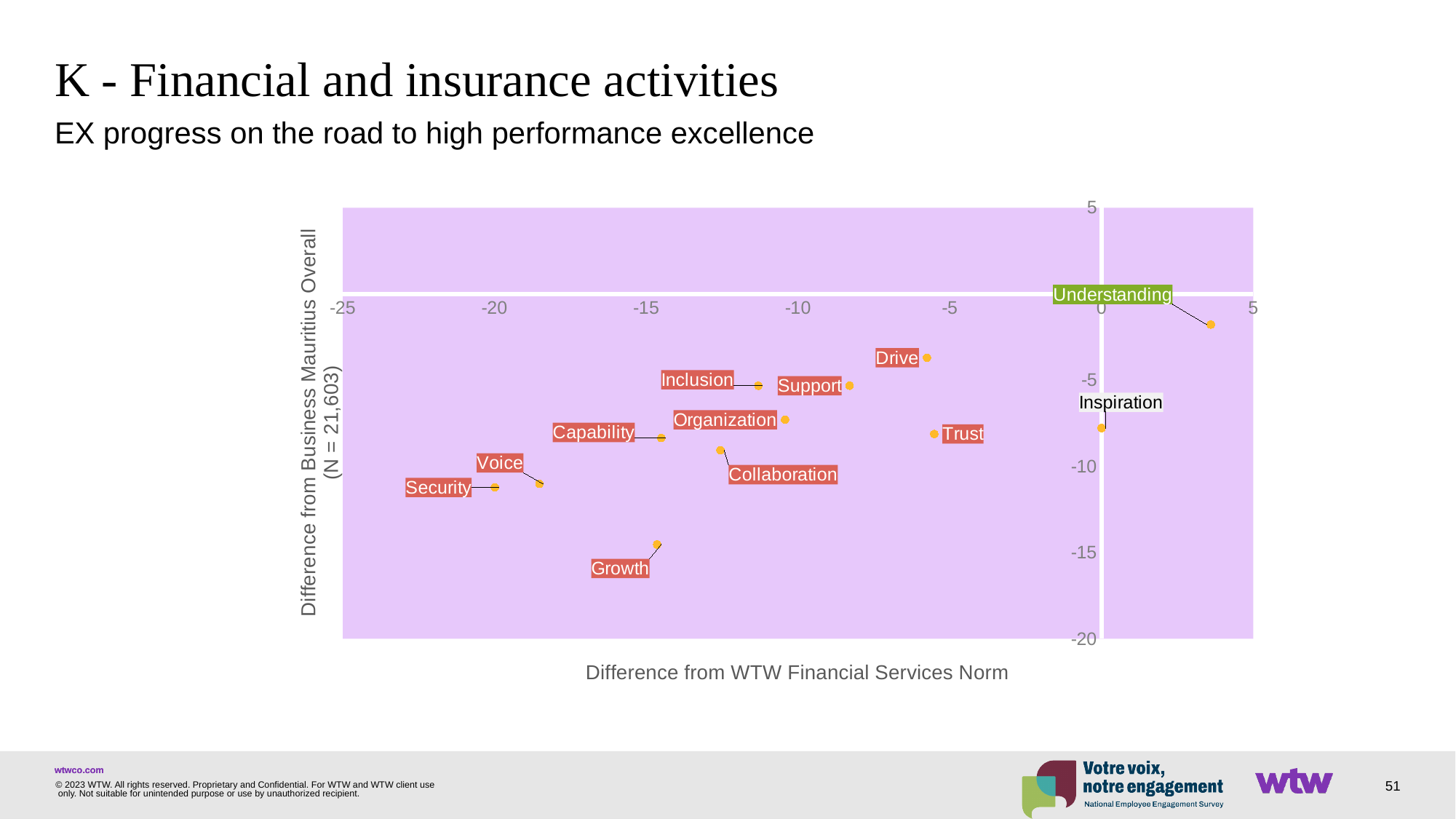
Which labelled point has the highest value on the vertical axis (Difference from Business Mauritius Overall)? Understanding Is the vertical-axis value for Drive greater or less than -5? greater Which labelled point has the lowest value on the vertical axis (Difference from Business Mauritius Overall)? Growth How many labelled data points are plotted on the chart? 12 Which has the larger horizontal-axis value, Security or Trust? Trust Which labelled point has the highest value on the horizontal axis (Difference from WTW Financial Services Norm)? Understanding Is the vertical-axis value for Growth greater or less than -10? less Is the horizontal-axis value for Trust greater or less than -10? greater What is the title of the horizontal axis of the chart? Difference from WTW Financial Services Norm Which has the larger vertical-axis value, Drive or Growth? Drive What kind of chart is shown on the slide? Scatter chart